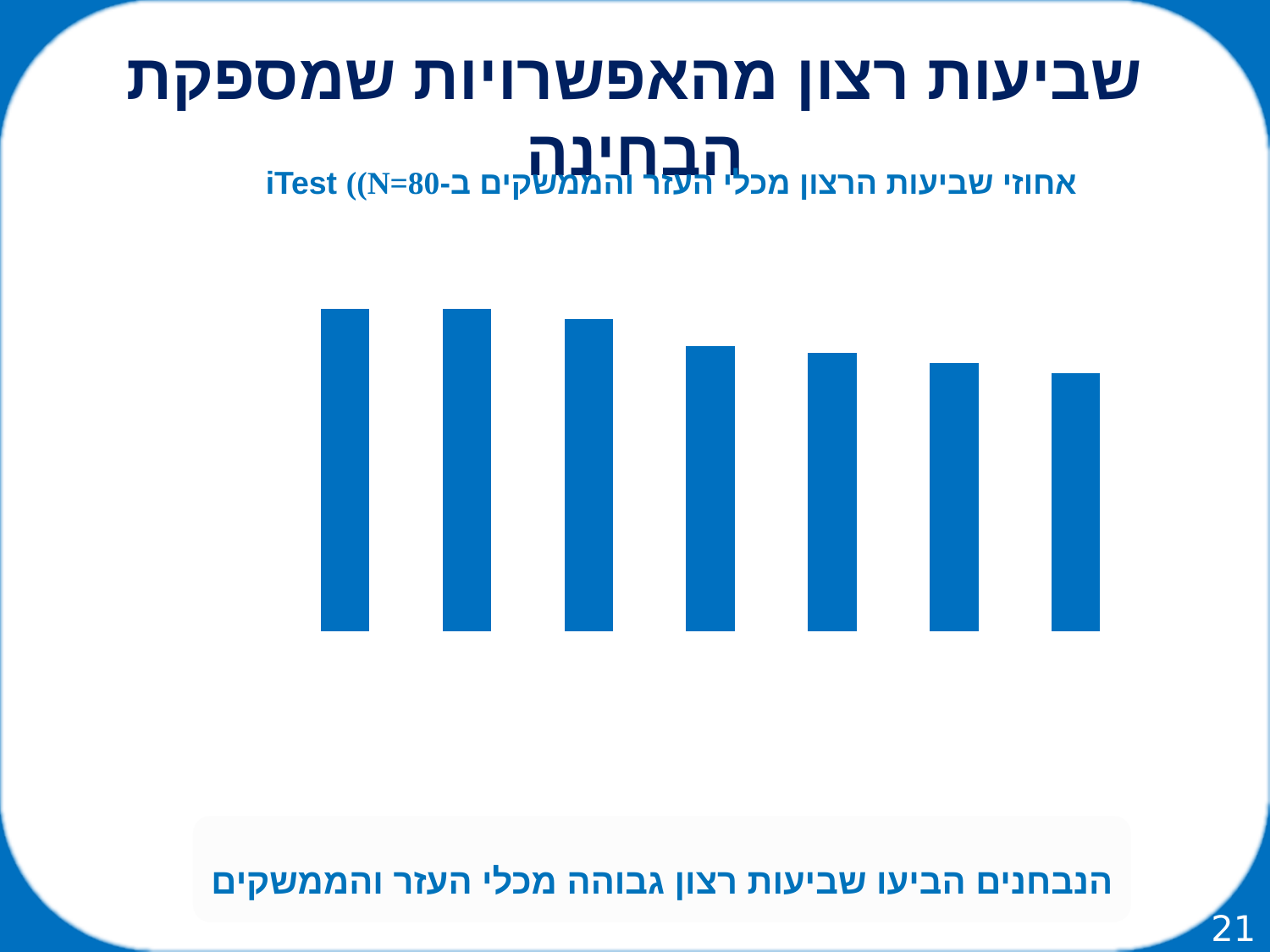
Do the bar values rise or fall from left to right across the chart? fall What kind of chart is shown on the slide? bar chart What colour are the bars in the chart? blue How many bars does the chart contain? 7 Which is larger, the leftmost bar or the rightmost bar? the leftmost bar What sample size (N) is stated in the chart title? N=80 Which is larger, the third bar from the left or the fifth bar from the left? the third bar from the left Which bar is the lowest in the chart? the rightmost bar Which is larger, the fourth bar from the left or the sixth bar from the left? the fourth bar from the left